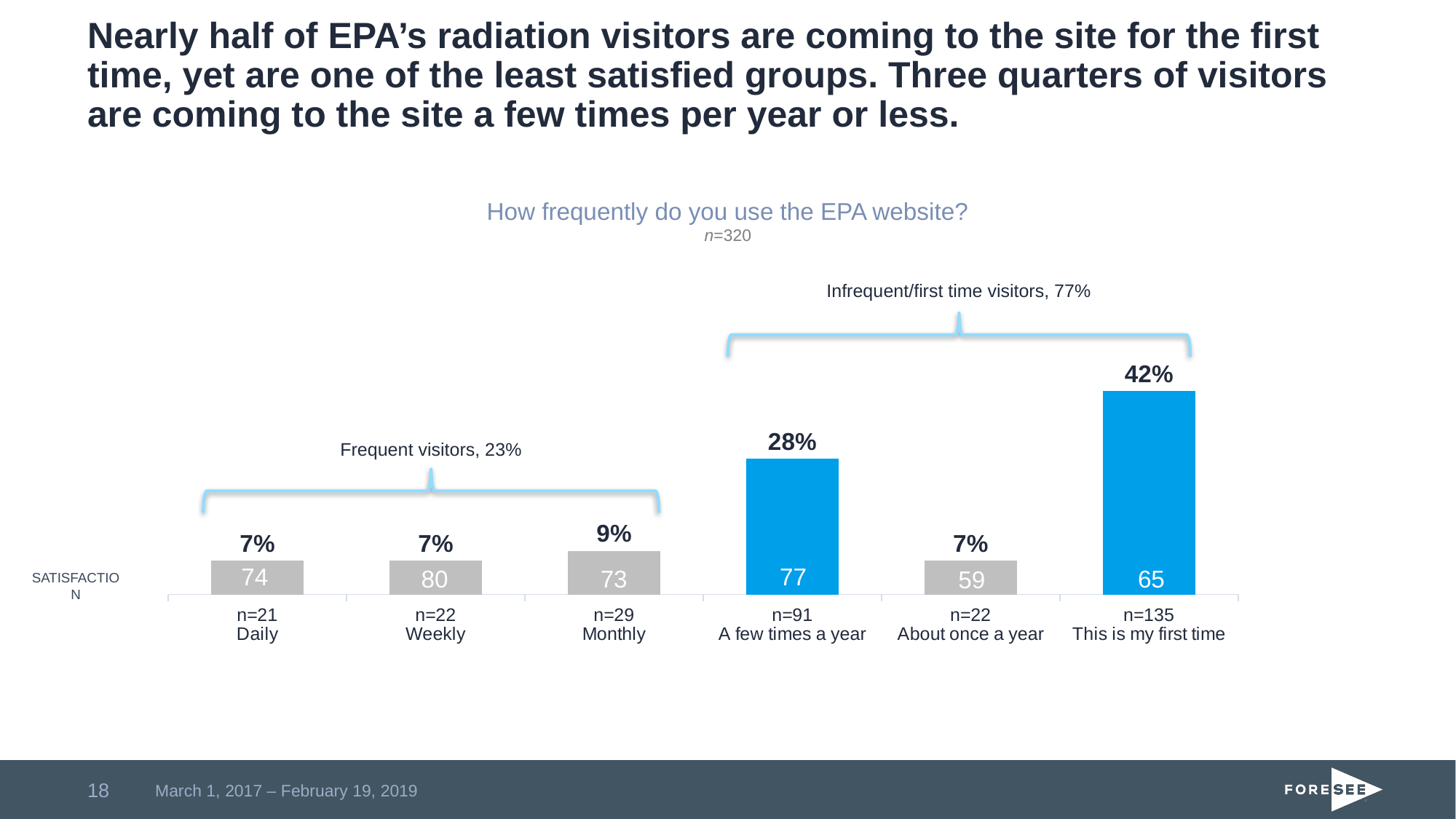
Which has a higher percentage of respondents, Monthly or Daily? Monthly What percentage of respondents said this is their first time using the EPA website? 42% What is the satisfaction score shown for the About once a year group? 59 How many usage frequency categories are shown on the x axis? 6 What is the sample size (n) for the A few times a year category? 91 What percentage of respondents said they use the EPA website a few times a year? 28% What kind of chart is shown on the slide? Bar chart What is the title of the chart? How frequently do you use the EPA website? What is the satisfaction score shown for the Weekly group? 80 What is the difference in percentage points between the This is my first time and A few times a year categories? 14 What percentage of respondents said they use the EPA website monthly? 9% Which usage frequency category has the highest percentage of respondents? This is my first time